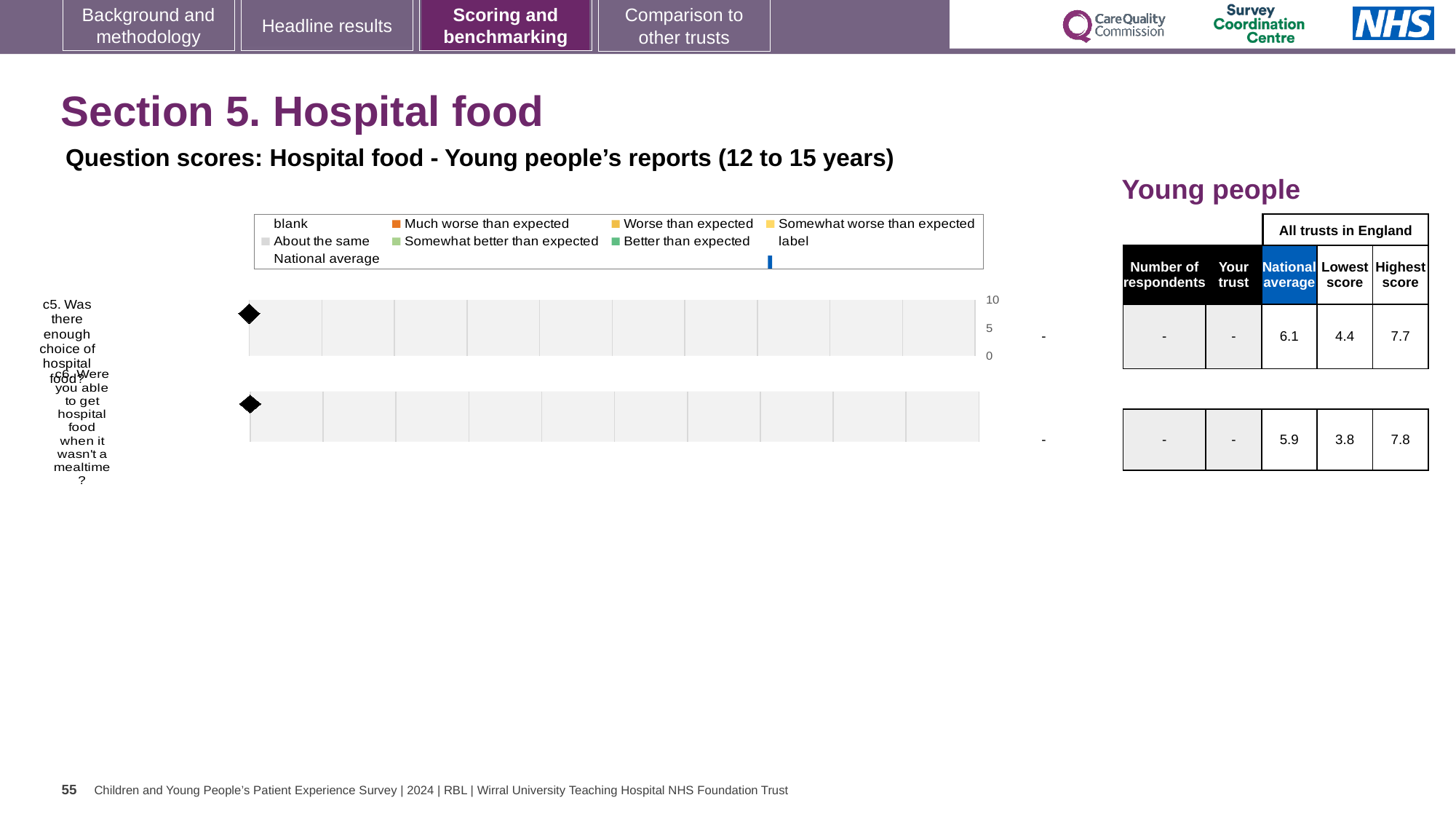
What is the difference between the highest score and the lowest score for c6 in the table? 4.0 What kind of chart is shown on the slide? bar chart In the table next to the chart, what is the national average score for c5 (Was there enough choice of hospital food?)? 6.1 How many survey questions (categories) are listed on the chart's vertical axis? 2 In the table next to the chart, what is the lowest score for c5 (Was there enough choice of hospital food?)? 4.4 What is the highest value shown on the chart's numeric axis? 10 Which question has the higher national average in the table, c5 or c6? c5 In the table next to the chart, what is the national average score for c6 (Were you able to get hospital food when it wasn't a mealtime?)? 5.9 What value is shown for 'Your trust' for c5 in the table? - What is the difference between the highest score and the lowest score for c5 in the table? 3.3 In the table next to the chart, what is the highest score for c6 (Were you able to get hospital food when it wasn't a mealtime?)? 7.8 Which legend entry is represented by an orange marker? Much worse than expected